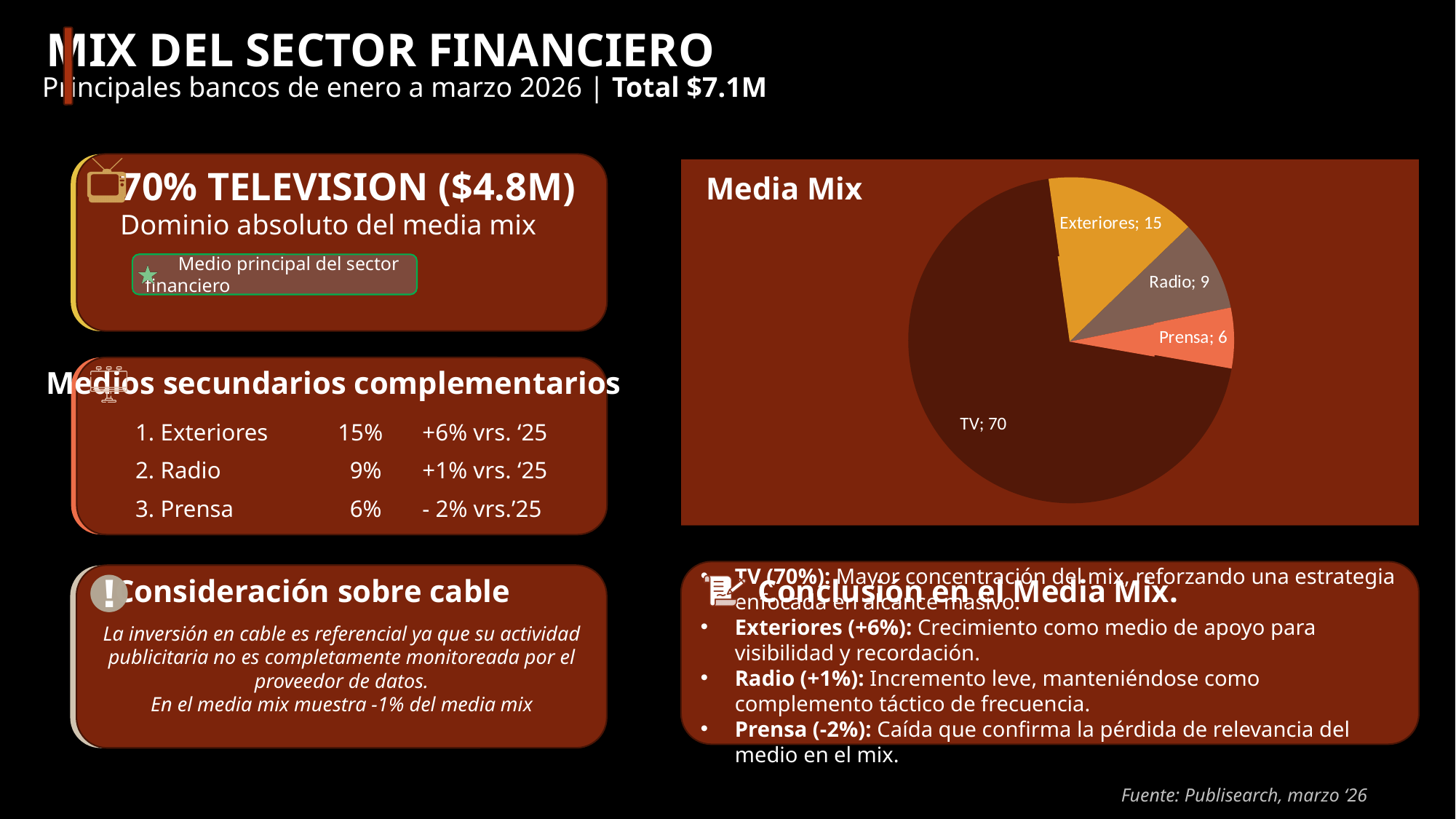
What is the difference between the TV and Exteriores values in the Media Mix chart? 55 In the Media Mix chart, which is larger, Exteriores or Radio? Exteriores What is the difference between the Radio and Prensa values in the Media Mix chart? 3 What type of chart is the Media Mix chart? pie chart What is the value for TV in the Media Mix chart? 70 How many slices does the Media Mix pie chart have? 4 Which category has the smallest slice in the Media Mix chart? Prensa Which category has the largest slice in the Media Mix chart? TV What is the title of the pie chart on the slide? Media Mix What is the value for Prensa in the Media Mix chart? 6 What is the value for Radio in the Media Mix chart? 9 What is the value for Exteriores in the Media Mix chart? 15